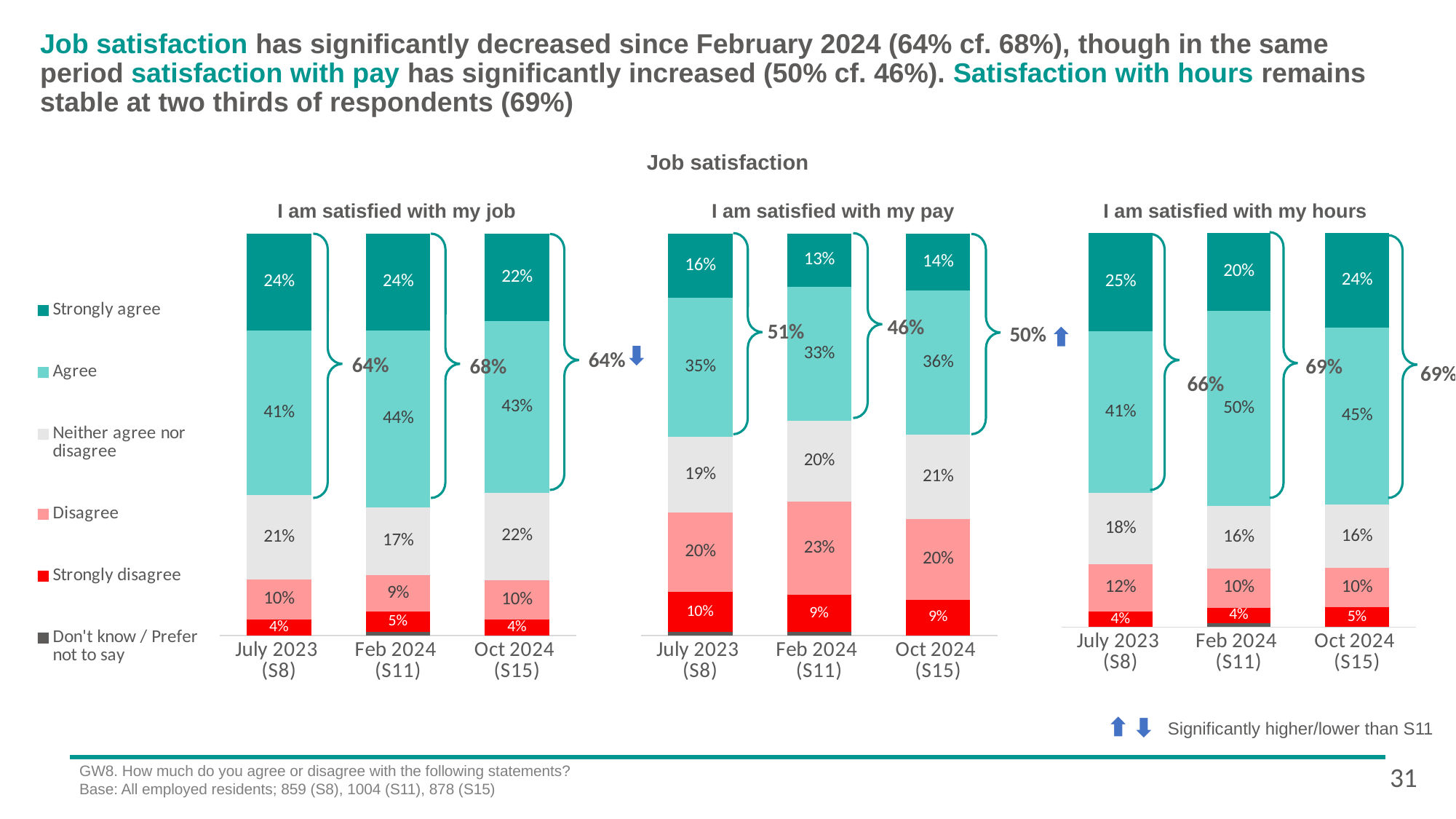
In the 'I am satisfied with my pay' chart, what combined agreement percentage is shown by the bracket for Oct 2024 (S15)? 50% In the 'I am satisfied with my job' chart, how many percentage points higher is 'Neither agree nor disagree' in Oct 2024 (S15) than in Feb 2024 (S11)? 5 percentage points In the 'I am satisfied with my pay' chart, which period has the larger 'Agree' value: Feb 2024 (S11) or Oct 2024 (S15)? Oct 2024 (S15) In the 'I am satisfied with my job' chart, what percentage of respondents chose 'Agree' in Feb 2024 (S11)? 44% How many bars (survey periods) are shown in the 'I am satisfied with my job' chart? 3 In the 'I am satisfied with my hours' chart, what is the 'Strongly agree' value for Oct 2024 (S15)? 24% In the 'I am satisfied with my pay' chart, which period has the lowest 'Strongly agree' value? Feb 2024 (S11) In the 'I am satisfied with my pay' chart, what is the 'Disagree' value for Feb 2024 (S11)? 23% How many response categories does the legend list? 6 In the 'I am satisfied with my pay' chart, does the 'Neither agree nor disagree' value rise or fall from July 2023 to Oct 2024? Rise In the 'I am satisfied with my hours' chart, which period has the highest 'Agree' value? Feb 2024 (S11) What type of chart is used to show the job satisfaction results? Stacked bar chart